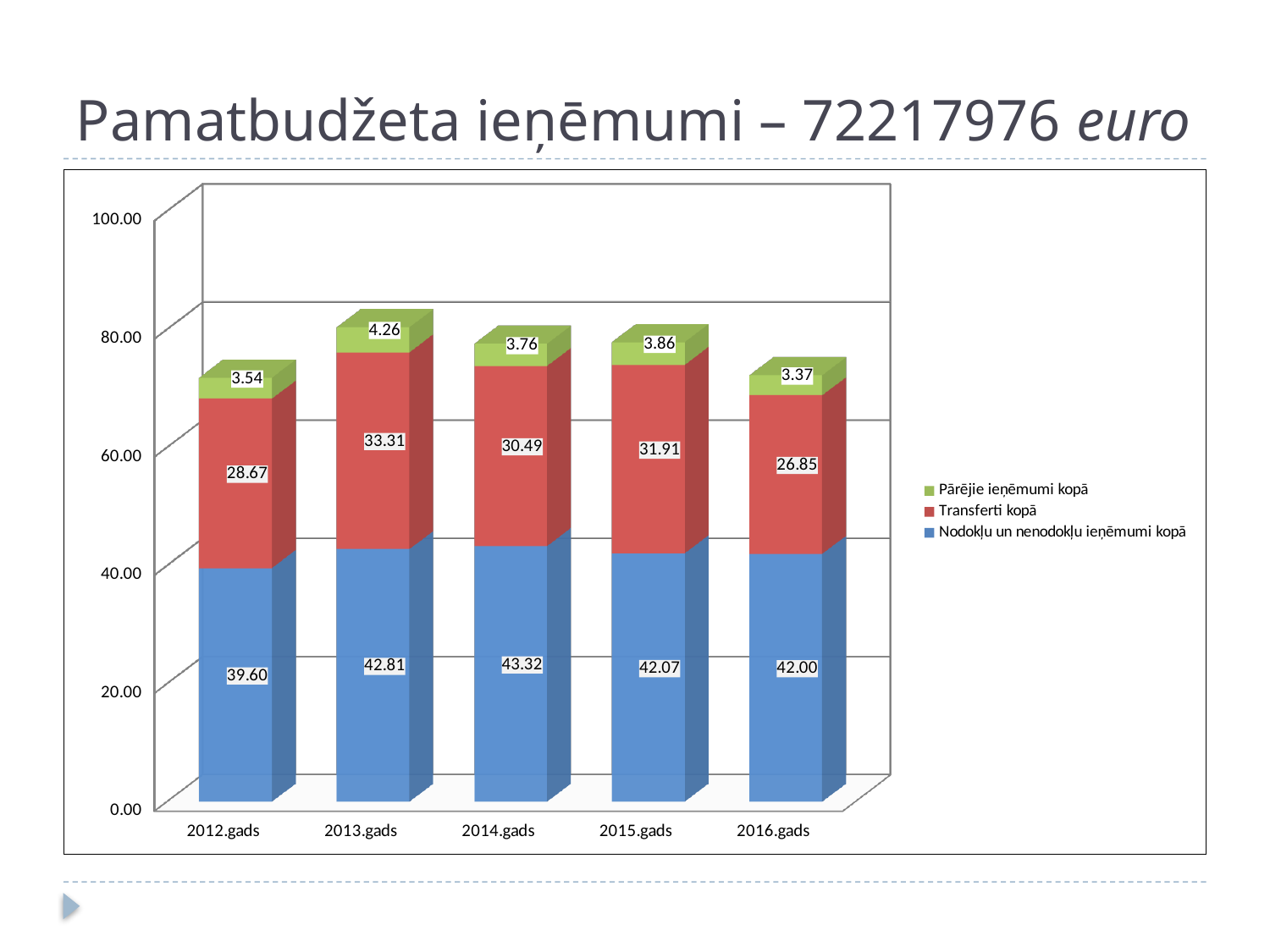
What is the value of Pārējie ieņēmumi kopā for 2016.gads? 3.37 How many years are shown on the x axis? 5 What is the title of the slide containing the chart? Pamatbudžeta ieņēmumi – 72217976 euro What is the value of Nodokļu un nenodokļu ieņēmumi kopā for 2014.gads? 43.32 Which year has the lowest value for Nodokļu un nenodokļu ieņēmumi kopā? 2012.gads What kind of chart is shown on the slide? Stacked bar chart What is the total of the stacked bar for 2013.gads? 80.38 Which is larger: Pārējie ieņēmumi kopā for 2014.gads or for 2015.gads? 2015.gads How many series does the legend list? 3 What is the value of Transferti kopā for 2013.gads? 33.31 Which year has the highest value for Transferti kopā? 2013.gads What is the difference between the Transferti kopā values for 2015.gads and 2016.gads? 5.06